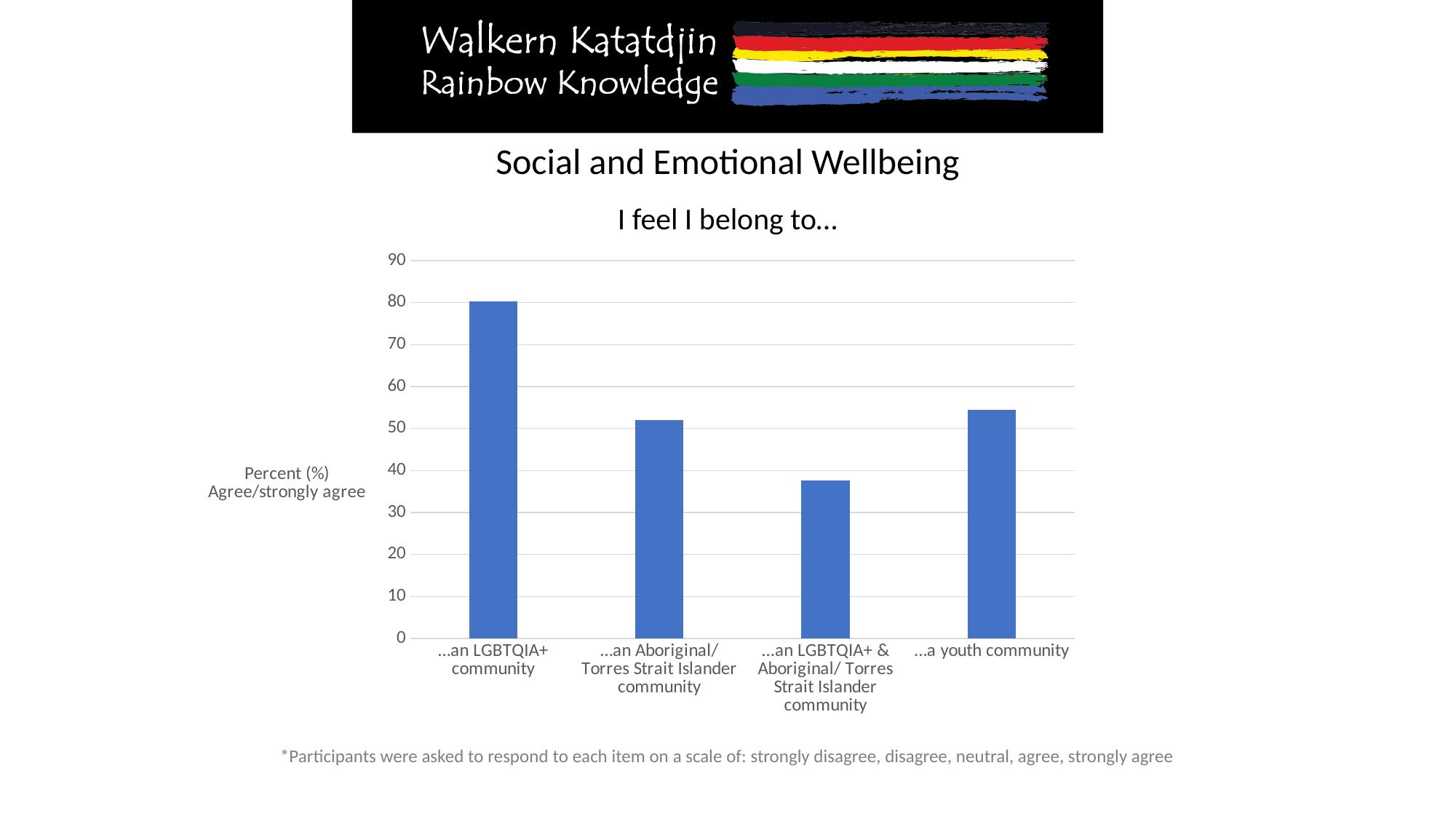
Is the value for '…an LGBTQIA+ & Aboriginal/ Torres Strait Islander community' greater or less than 40? less Is the value for '…a youth community' greater or less than 60? less Is the value for '…an LGBTQIA+ community' greater or less than 70? greater What kind of chart is shown on the slide? bar chart How many categories are shown on the x axis of the chart? 4 Which is larger: the value for '…an Aboriginal/ Torres Strait Islander community' or the value for '…an LGBTQIA+ & Aboriginal/ Torres Strait Islander community'? …an Aboriginal/ Torres Strait Islander community What is the title of the chart? I feel I belong to… What is the label on the vertical axis of the chart? Percent (%) Agree/strongly agree Which is larger: the value for '…an LGBTQIA+ community' or the value for '…a youth community'? …an LGBTQIA+ community Which category has the highest value? …an LGBTQIA+ community Which category has the lowest value? …an LGBTQIA+ & Aboriginal/ Torres Strait Islander community